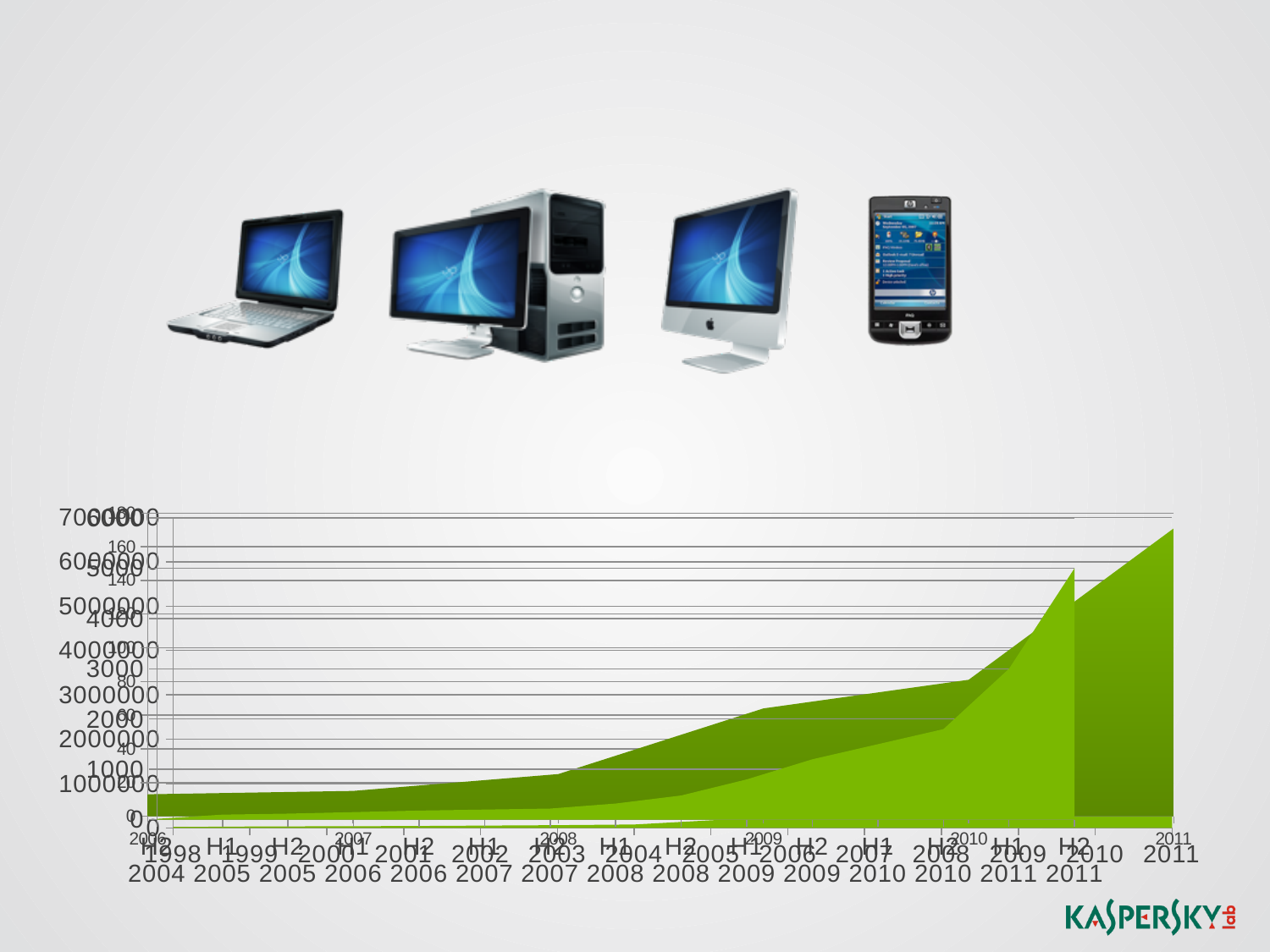
What is the last year label shown on the x axis of the chart? 2011 What colour are the plotted areas in the chart? green What is the highest tick value shown on the outermost y axis of the chart? 7000000 What is the first year label on the x axis that runs from 1998? 1998 How many year labels are there on the x axis that runs from 1998 to 2011? 14 Do the plotted values rise or fall from left to right along the x axis? rise What kind of chart is shown at the bottom of the slide? area chart